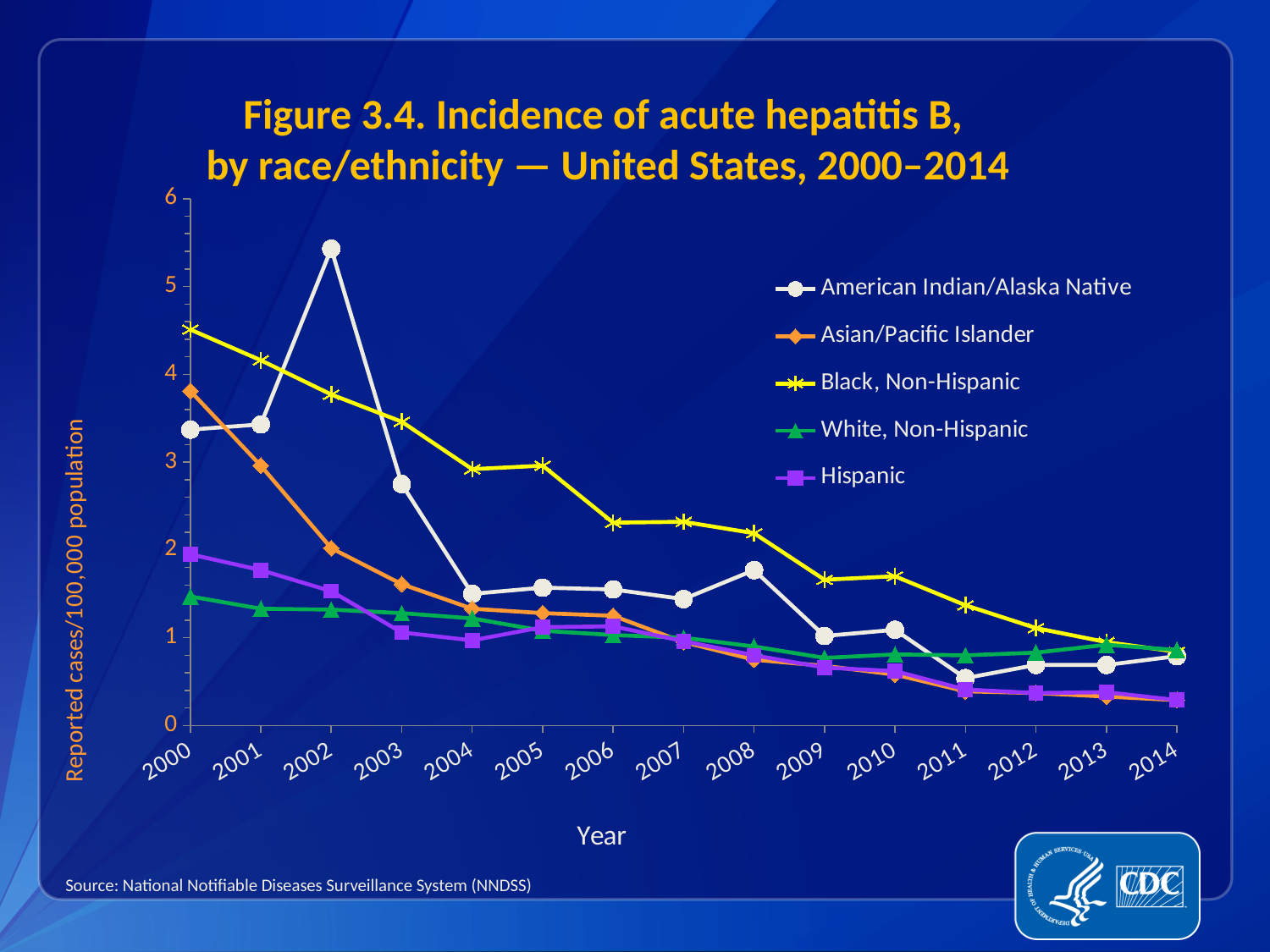
Which series has the lowest value in 2000? White, Non-Hispanic Is the value for American Indian/Alaska Native in 2002 greater or less than 5? greater In 2014, which is larger: the value for White, Non-Hispanic or the value for Hispanic? White, Non-Hispanic Is the value for Black, Non-Hispanic in 2000 greater or less than 4? greater Does the Black, Non-Hispanic series rise or fall from 2000 to 2014? fall How many series does the legend list? 5 Which series has the highest value in 2002? American Indian/Alaska Native How many years are plotted along the x axis? 15 Which series has the highest value in 2000? Black, Non-Hispanic What kind of chart is shown on the slide? line chart In which year does the American Indian/Alaska Native series reach its peak? 2002 Is the value for Hispanic in 2014 greater or less than 1? less